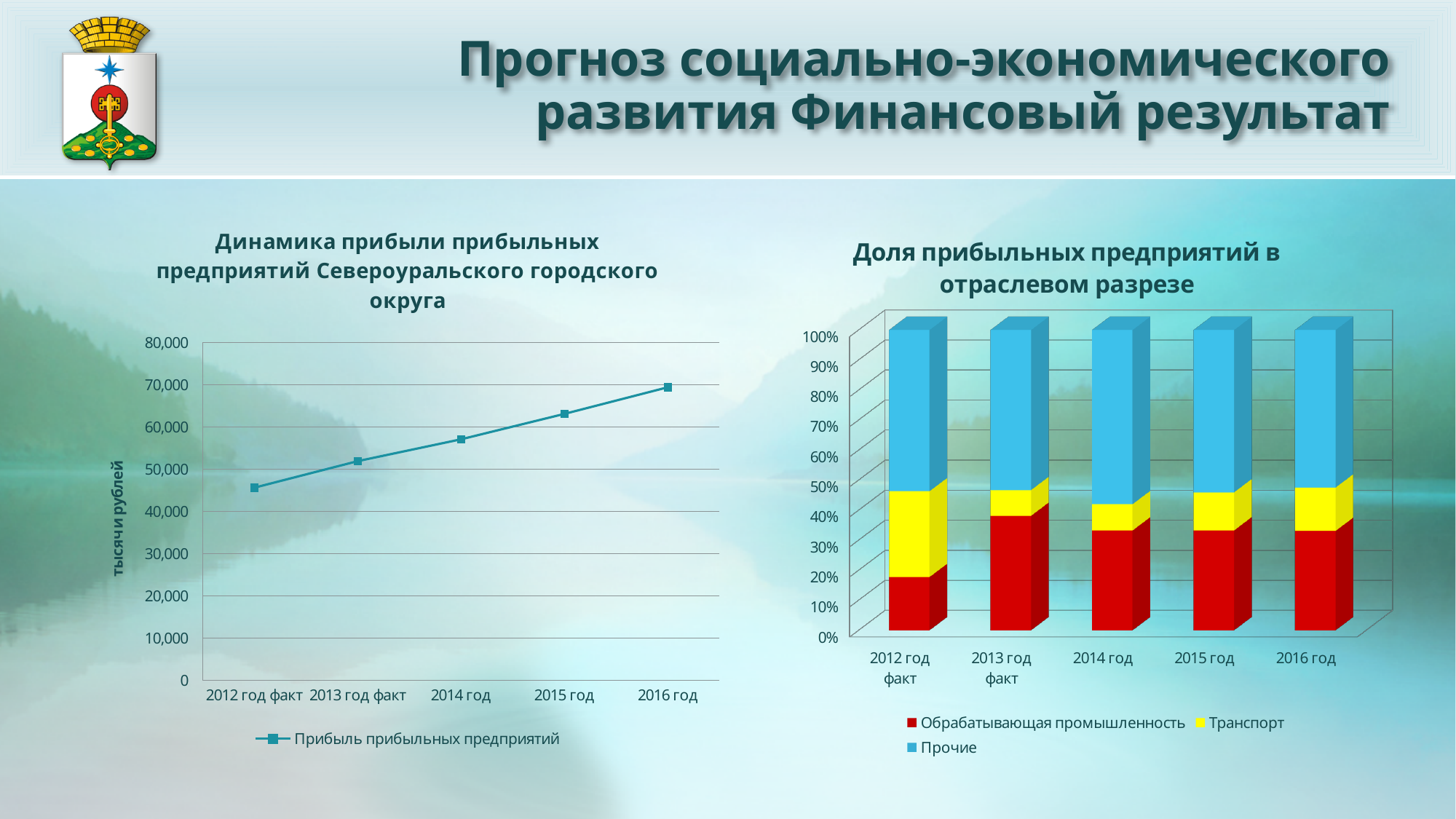
In the right chart, which is larger for 2012 год факт: the share of Прочие or the share of Обрабатывающая промышленность? Прочие In the left chart, which category has the highest value? 2016 год In the left chart, is the value for 2012 год факт greater or less than 50,000? less In the left chart, how many points are plotted along the x axis? 5 How many series does the legend of the right chart list? 3 In the left chart, is the value for 2016 год greater or less than 60,000? greater What kind of chart is the left chart titled "Динамика прибыли прибыльных предприятий Североуральского городского округа"? line chart In the right chart, is the share of Обрабатывающая промышленность for 2013 год факт greater or less than 30%? greater What kind of chart is the right chart titled "Доля прибыльных предприятий в отраслевом разрезе"? stacked bar chart In the left chart, do the values rise or fall from 2012 год факт to 2016 год? rise In the left chart, which category has the lowest value? 2012 год факт What is the y-axis title of the left chart? тысячи рублей